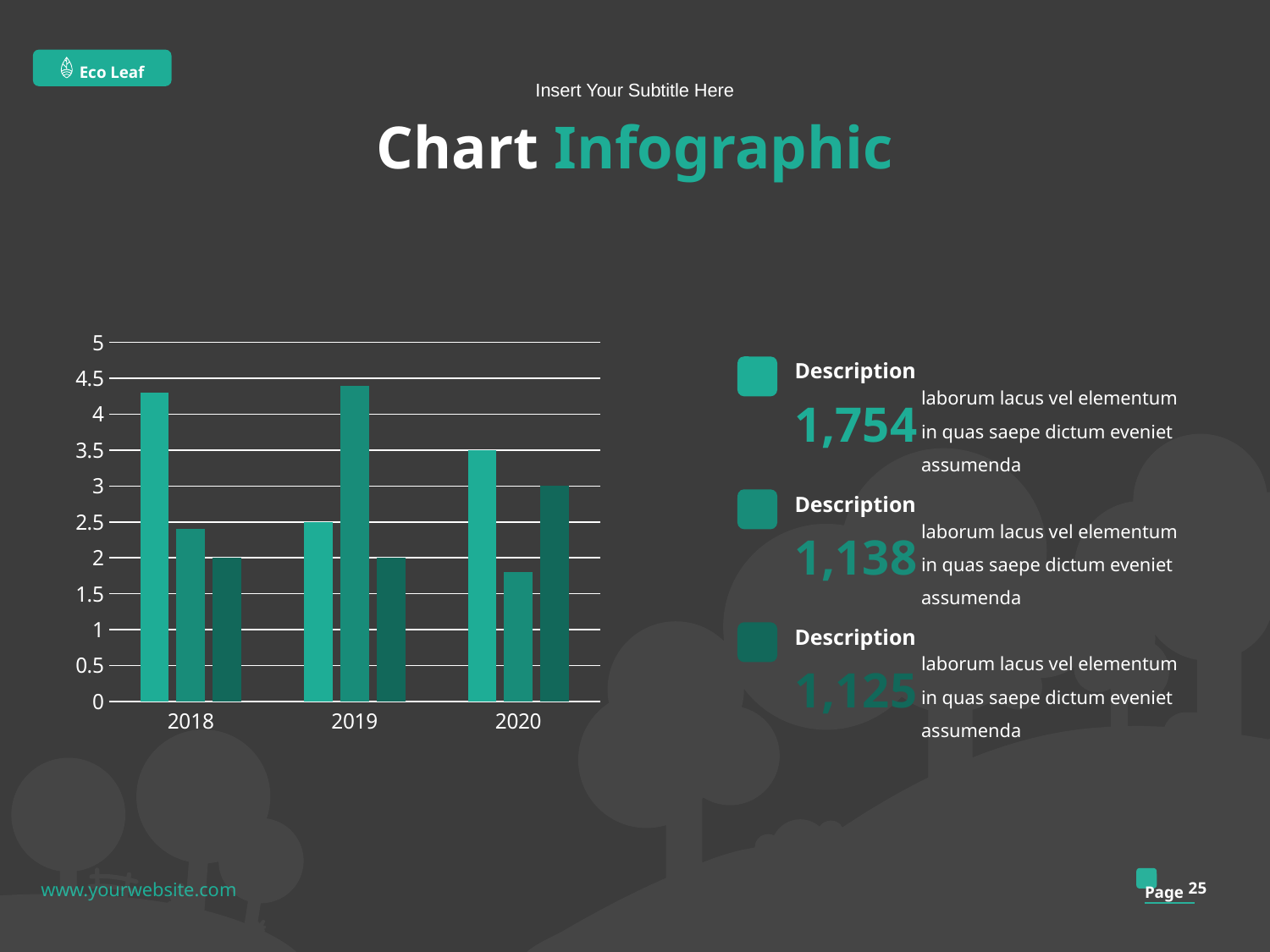
Is the value of the middle bar for 2018 greater or less than 2? greater Is the value of the leftmost (lightest) bar for 2018 greater or less than 4? greater What is the highest value shown on the chart's vertical axis? 5 Which is larger: the leftmost (lightest) bar for 2018 or the leftmost (lightest) bar for 2019? 2018 Within the 2020 group, which bar is the lowest? the middle bar What kind of chart is shown on the slide? bar chart How many bars are plotted for each year in the chart? 3 Which year has the tallest bar overall in the chart? 2019 Is the value of the middle bar for 2019 greater or less than 4? greater How many categories are shown on the x axis of the chart? 3